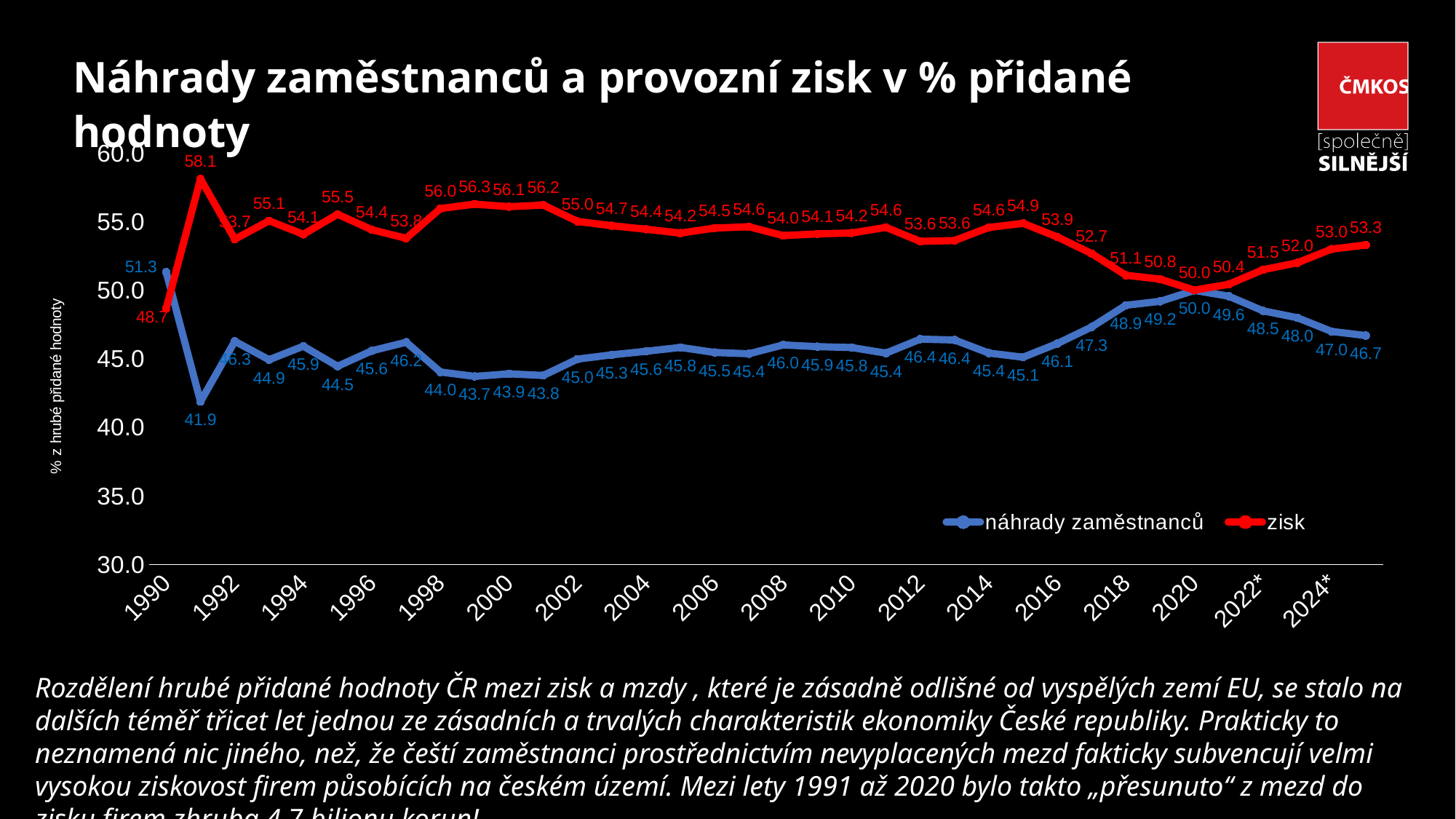
In 1990, which series has the larger value, náhrady zaměstnanců or zisk? náhrady zaměstnanců In which year does zisk reach its highest value? 1991 Does náhrady zaměstnanců rise or fall between 2016 and 2020? rise What is the value of náhrady zaměstnanců in 2020? 50.0 What kind of chart is shown on the slide? line chart What is the value of zisk in 1991? 58.1 What colour is the line for zisk? red What is the value of zisk in 2024*? 53.0 How many series does the legend list? 2 What is the value of náhrady zaměstnanců in 1991? 41.9 In which year is náhrady zaměstnanců at its lowest? 1991 What is the difference between náhrady zaměstnanců and zisk in 1990? 2.6